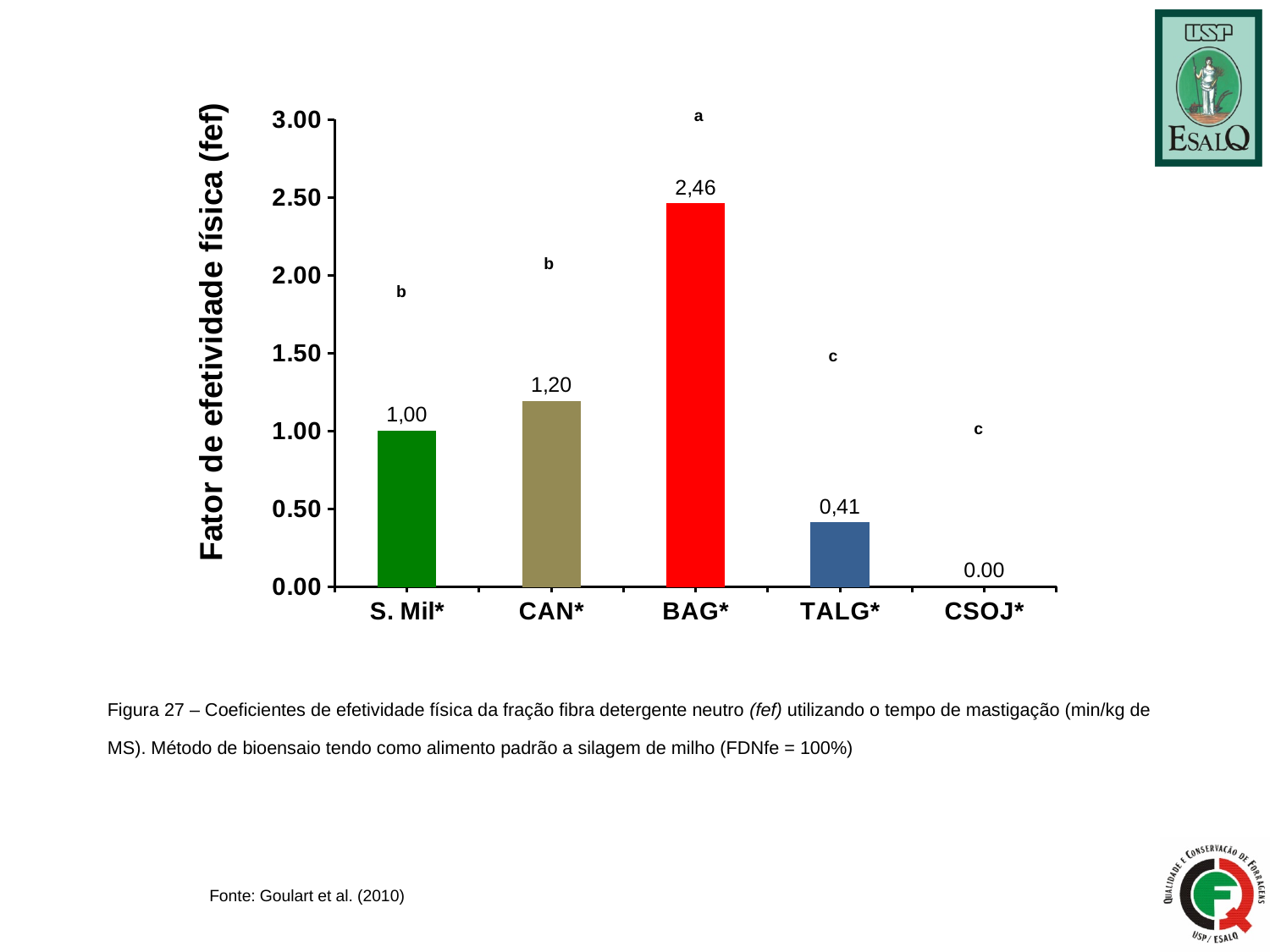
What is the value for CAN*? 1,20 What is the difference between the values for BAG* and CAN*? 1,26 Which is larger, the value for CAN* or the value for S. Mil*? CAN* How many categories are shown on the x axis? 5 What is the label of the y axis? Fator de efetividade física (fef) What kind of chart is this? Bar chart Which category has the lowest value? CSOJ* What is the value for BAG*? 2,46 What is the difference between the values for S. Mil* and TALG*? 0,59 Which category has the highest value? BAG* What is the value for CSOJ*? 0.00 What is the value for TALG*? 0,41